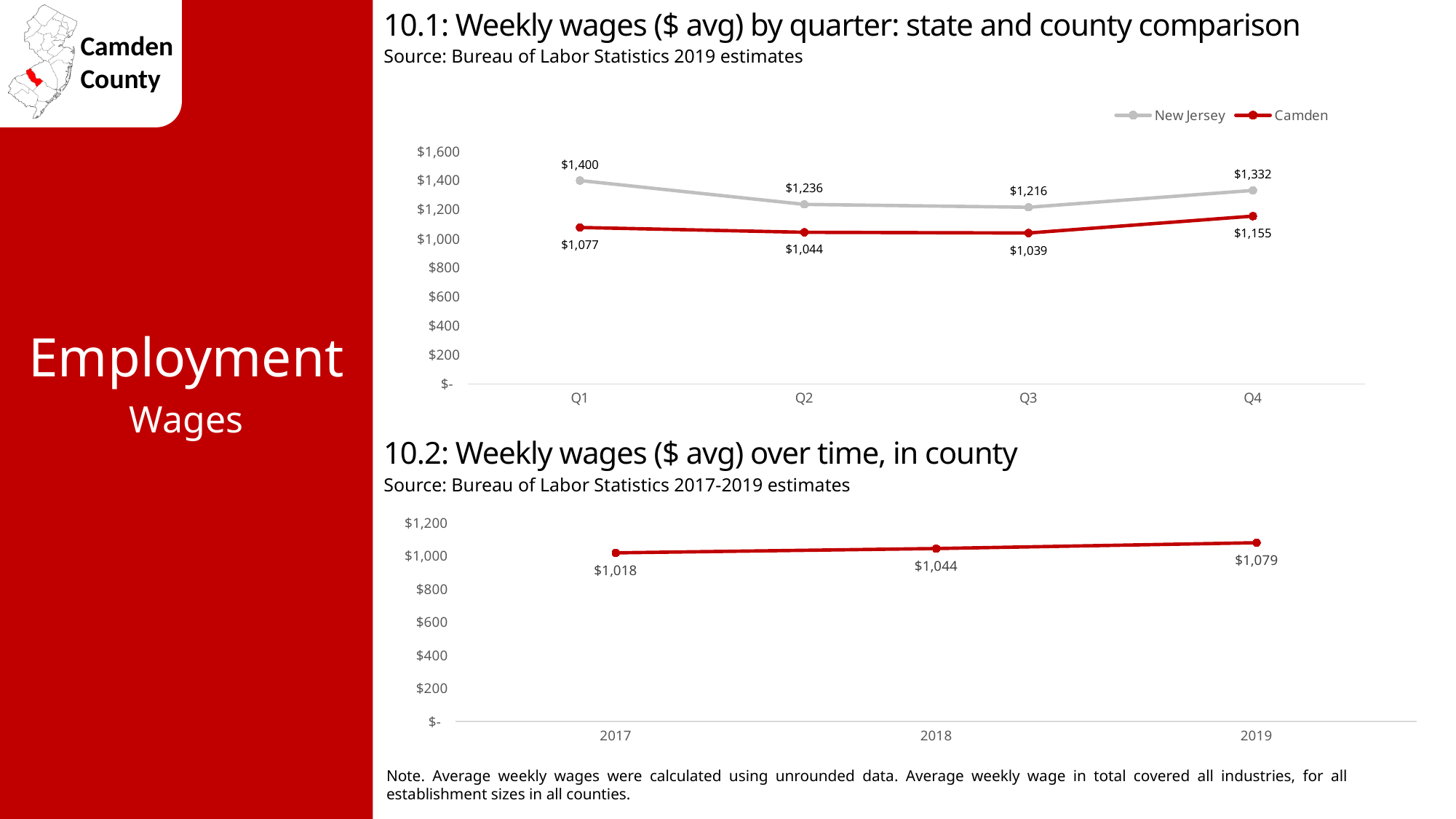
In chart 10.1, which quarter has the lowest New Jersey weekly wage? Q3 In chart 10.2, how many years are plotted? 3 In chart 10.1, what is the difference between the New Jersey and Camden weekly wages in Q4? $177 In chart 10.1, what is the Camden weekly wage in Q3? $1,039 In chart 10.2, do weekly wages rise or fall from 2017 to 2019? Rise In chart 10.1, what is the New Jersey weekly wage in Q1? $1,400 In chart 10.2, what is the difference between the 2019 and 2017 weekly wages? $61 In chart 10.2, what is the weekly wage in 2018? $1,044 In chart 10.1, which quarter has the highest Camden weekly wage? Q4 In chart 10.1, how many series does the legend list? 2 In chart 10.1, which is larger in Q2: the New Jersey wage or the Camden wage? New Jersey In chart 10.1, what type of chart is shown? Line chart